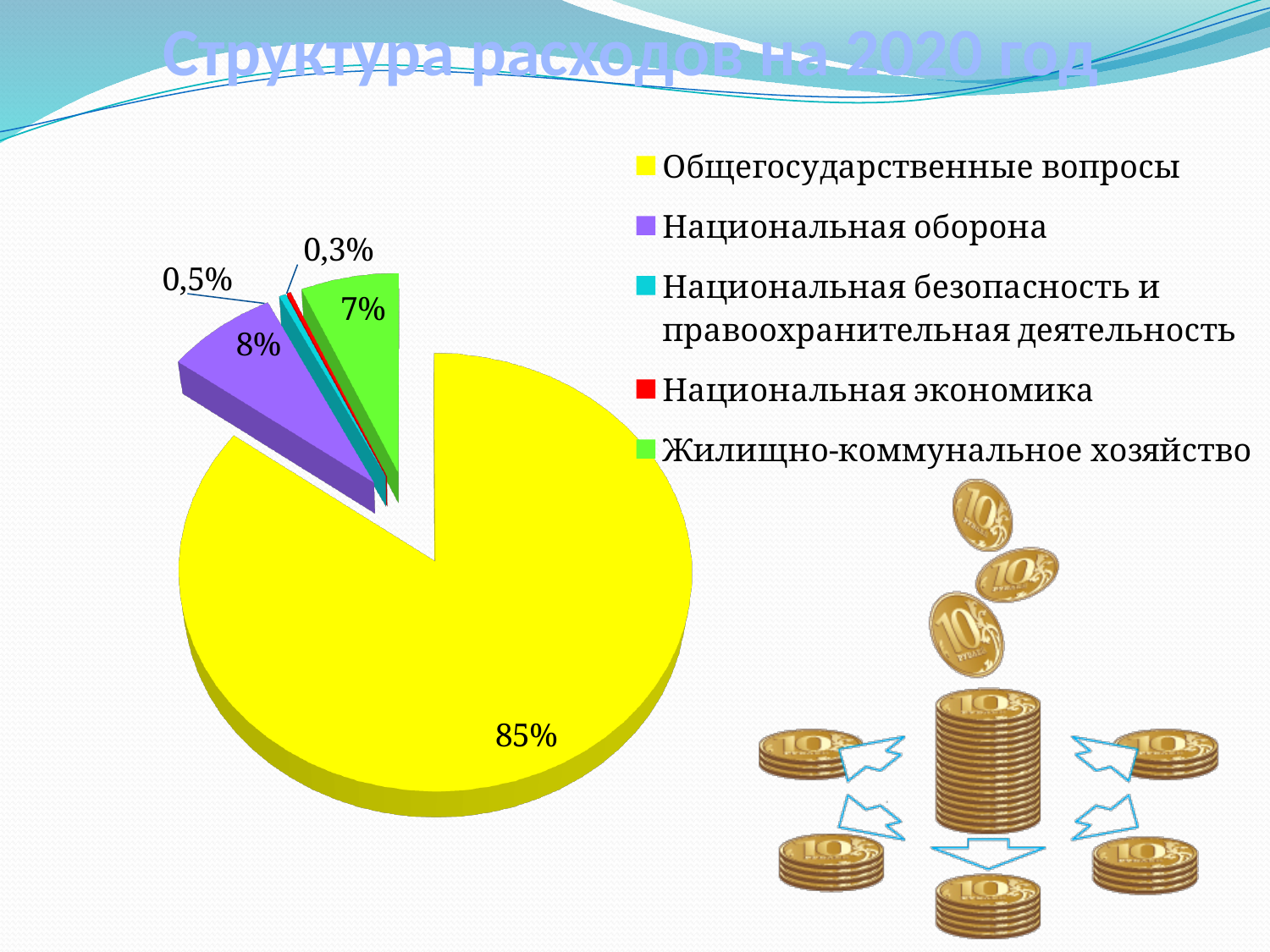
How many categories does the legend list? 5 What colour is the slice for Национальная экономика? Red What share of the pie is Национальная оборона? 8% Which category has the largest share of the pie? Общегосударственные вопросы Which category has the smallest share of the pie? Национальная экономика What is the title of the chart? Структура расходов на 2020 год What share of the pie is Жилищно-коммунальное хозяйство? 7% What share of the pie is Национальная экономика? 0,3% What share of the pie is Общегосударственные вопросы? 85% Which is larger: the share for Национальная оборона or the share for Жилищно-коммунальное хозяйство? Национальная оборона What share of the pie is Национальная безопасность и правоохранительная деятельность? 0,5% What kind of chart is shown on the slide? Pie chart